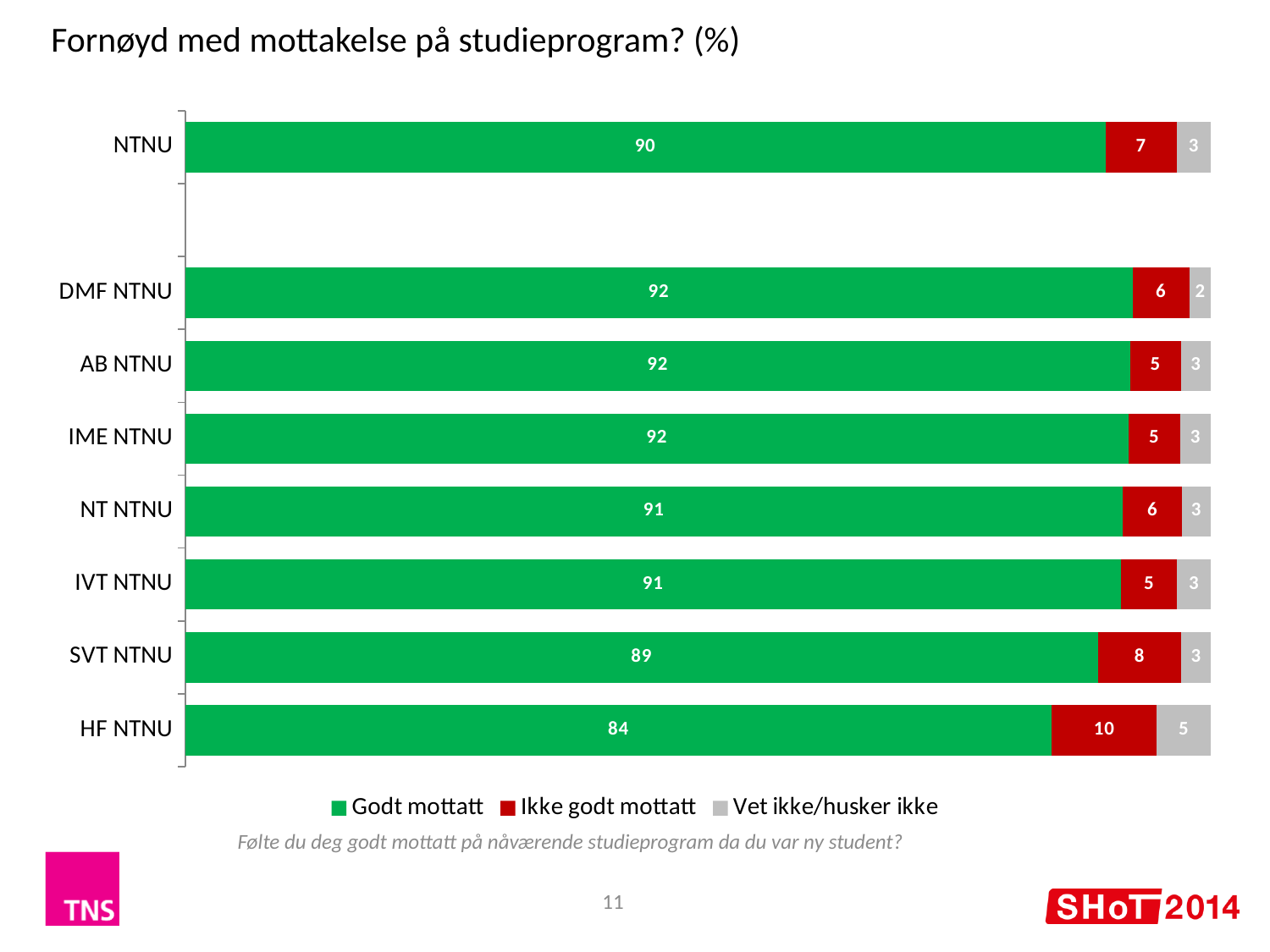
What kind of chart is shown on the slide? Stacked bar chart What is the 'Godt mottatt' value for NTNU? 90 Which category has the lowest 'Godt mottatt' value? HF NTNU How many categories are shown on the chart? 8 Which has a larger 'Ikke godt mottatt' value, SVT NTNU or IVT NTNU? SVT NTNU What is the difference between the 'Godt mottatt' values for DMF NTNU and HF NTNU? 8 What is the total of the stacked bar for HF NTNU? 99 What is the title of the chart? Fornøyd med mottakelse på studieprogram? (%) Which category has the highest 'Ikke godt mottatt' value? HF NTNU How many series does the legend list? 3 What is the 'Ikke godt mottatt' value for HF NTNU? 10 What is the 'Vet ikke/husker ikke' value for DMF NTNU? 2